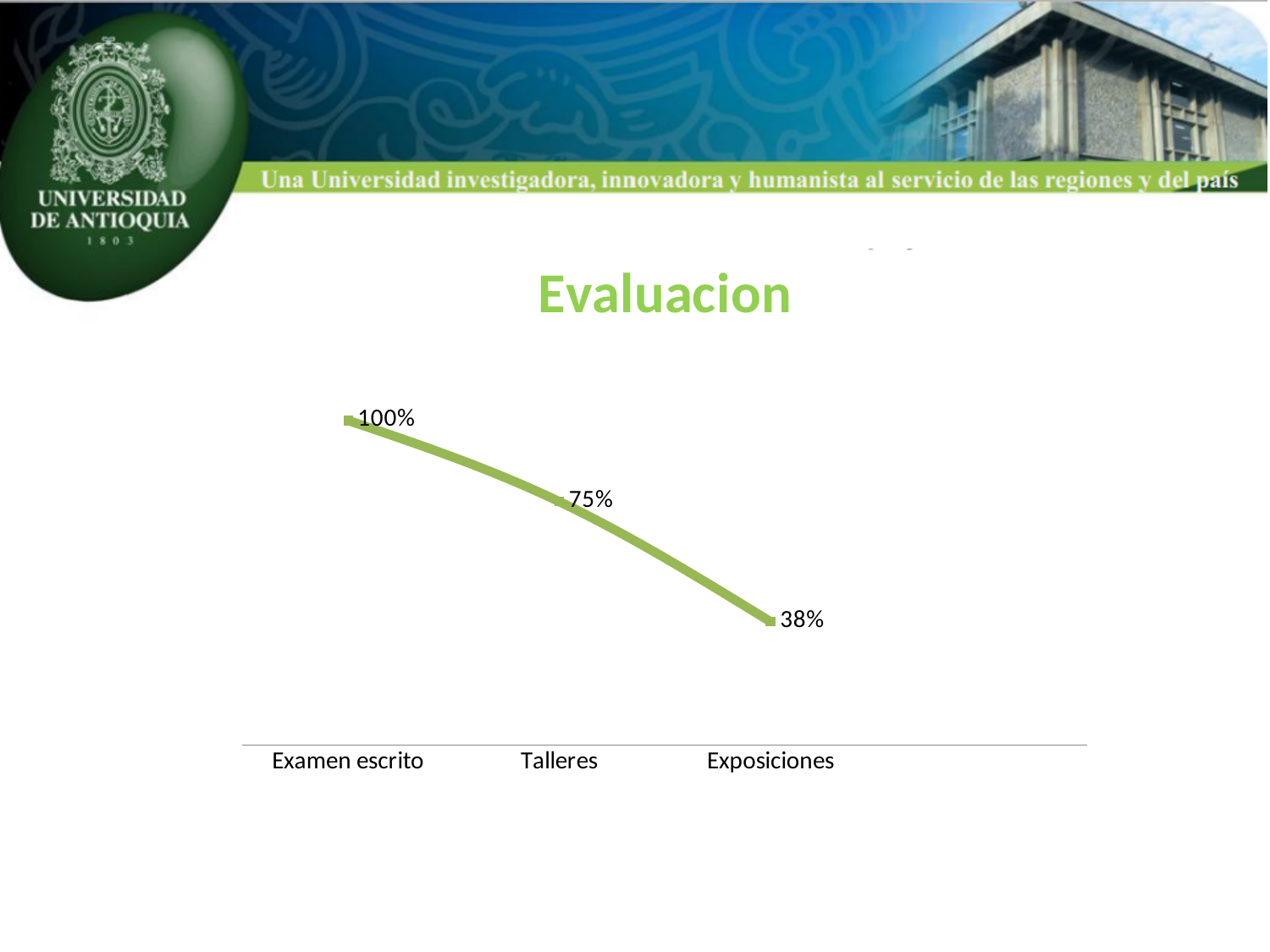
What is the value for Talleres? 75% Which category has the highest value? Examen escrito How many categories are plotted on the chart? 3 What is the value for Exposiciones? 38% What kind of chart is shown on the slide? Line chart What is the value for Examen escrito? 100% What is the difference between the values for Examen escrito and Talleres? 25% Which category has the lowest value? Exposiciones Do the values rise or fall from Examen escrito to Exposiciones? Fall Which is larger, the value for Talleres or the value for Exposiciones? Talleres What is the difference between the values for Talleres and Exposiciones? 37% What is the title of the chart? Evaluacion